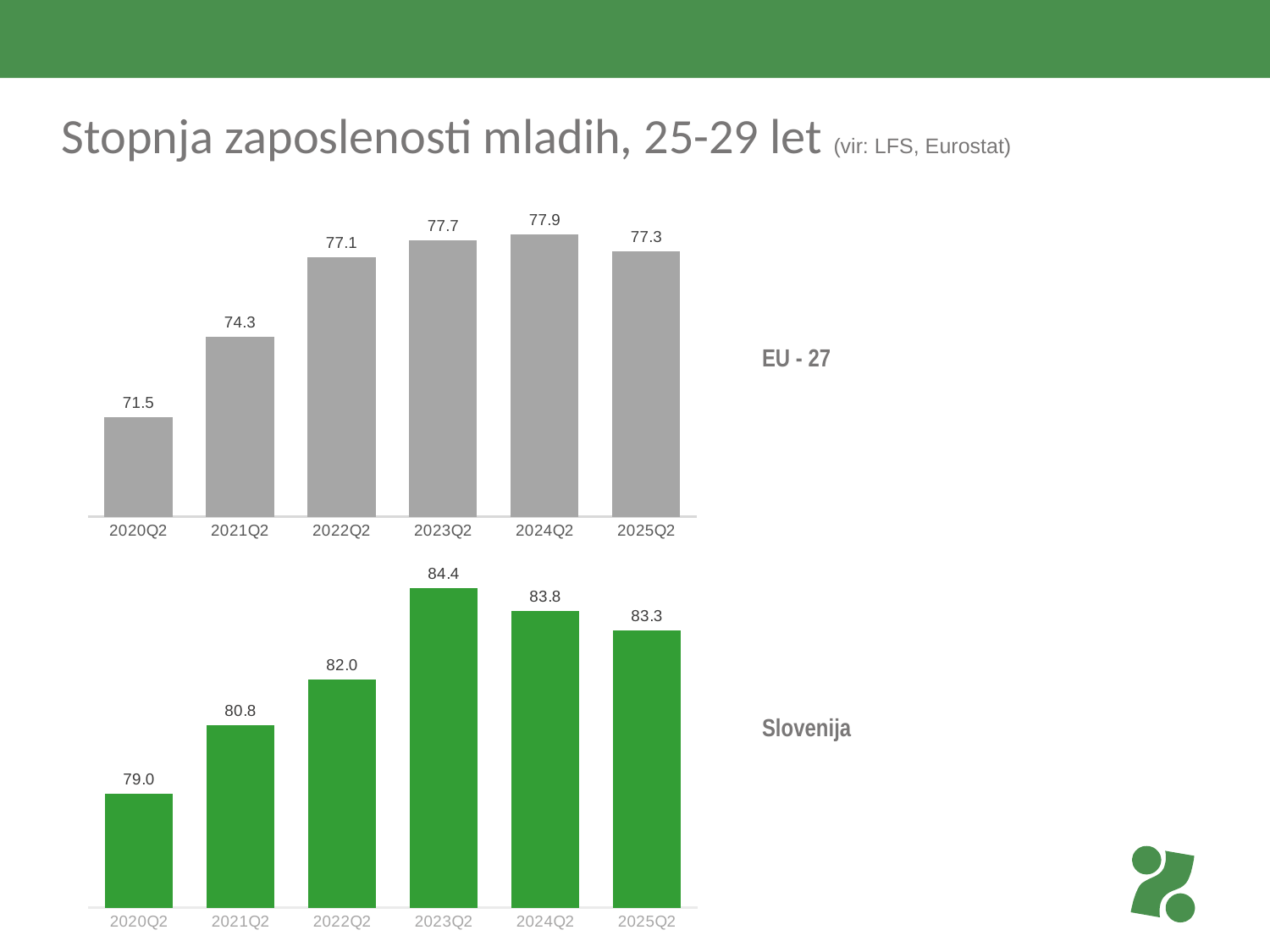
In the Slovenija chart, what is the difference between the values for 2023Q2 and 2020Q2? 5.4 In the Slovenija chart, what is the value for 2023Q2? 84.4 In the EU - 27 chart, which is larger, the value for 2022Q2 or the value for 2025Q2? 2025Q2 How many quarters are shown in the Slovenija chart? 6 In the EU - 27 chart, what is the value for 2020Q2? 71.5 In the EU - 27 chart, what is the value for 2025Q2? 77.3 What kind of chart is the EU - 27 chart? bar chart In the Slovenija chart, do the values rise or fall from 2020Q2 to 2023Q2? rise In the EU - 27 chart, what is the difference between the values for 2021Q2 and 2020Q2? 2.8 In the Slovenija chart, which quarter has the lowest value? 2020Q2 In the EU - 27 chart, which quarter has the highest value? 2024Q2 What colour are the bars in the Slovenija chart? green